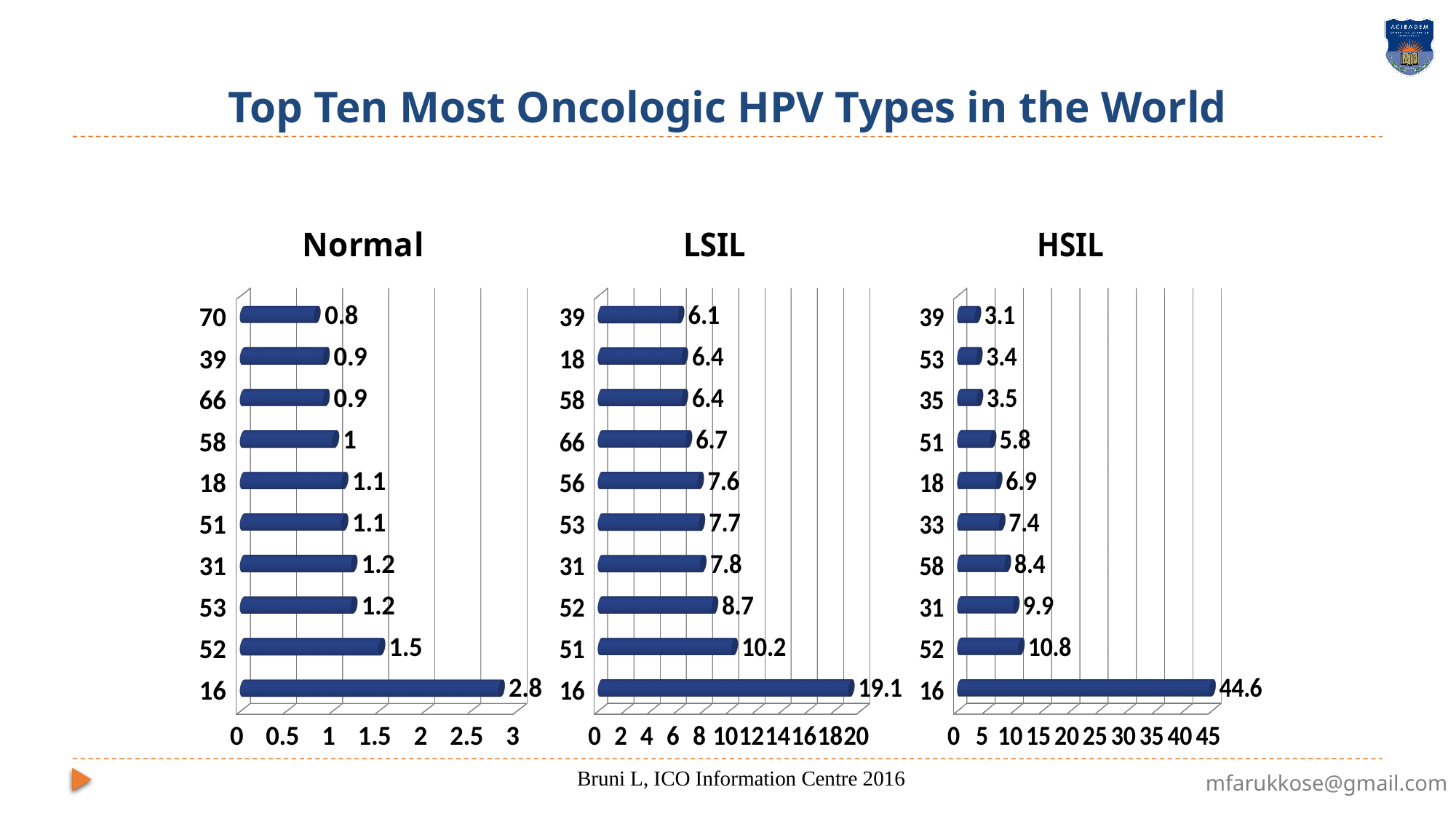
How many charts are shown on the slide? 3 In the HSIL chart, is the value for type 16 greater or less than 40? greater In the HSIL chart, what is the value for HPV type 52? 10.8 In the Normal chart, what is the value for HPV type 16? 2.8 In the HSIL chart, which HPV type has the highest value? 16 What kind of chart is the LSIL chart? bar chart In the Normal chart, which HPV type has the lowest value? 70 In the LSIL chart, what is the value for HPV type 51? 10.2 In the HSIL chart, what is the difference between the values for type 16 and type 52? 33.8 How many HPV types are shown in the Normal chart? 10 In the LSIL chart, what is the difference between the values for type 16 and type 51? 8.9 In the LSIL chart, which has a larger value, type 52 or type 31? 52